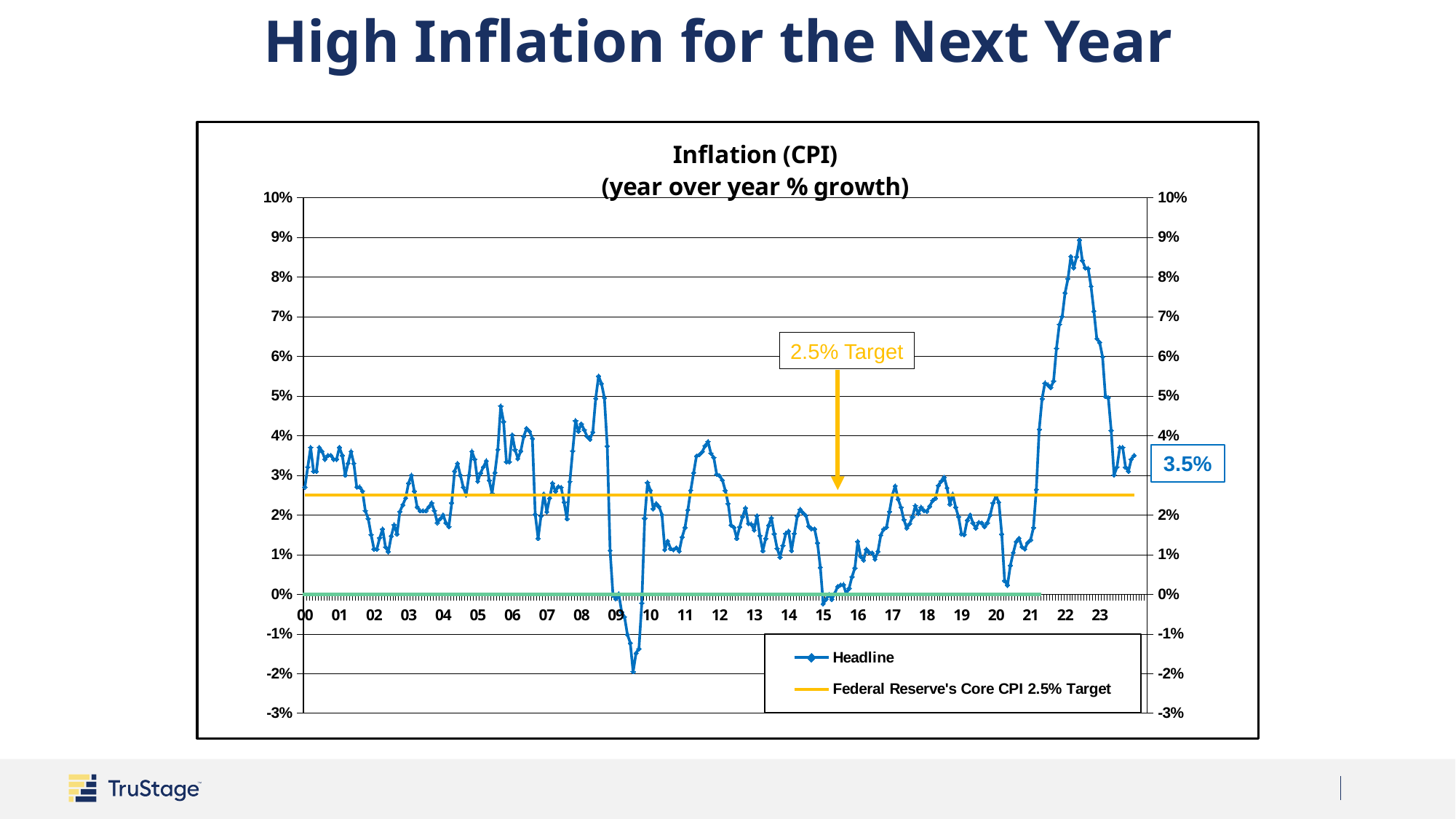
Which is larger, the latest labeled Headline value or the Federal Reserve's target? the latest Headline value (3.5%) What is the most recent Headline inflation value labeled on the chart? 3.5% What is the title of the chart? Inflation (CPI) (year over year % growth) What are the two legend entries on the chart? Headline; Federal Reserve's Core CPI 2.5% Target Is the peak Headline inflation value around 2022 greater or less than 8%? greater Is the lowest Headline inflation value around 2009 greater or less than -1%? less Is the Headline inflation value in 2015 greater or less than 1%? less How many series does the legend list? 2 By how much does the latest labeled Headline value (3.5%) exceed the 2.5% target? 1% What kind of chart is shown on the slide? line chart Do Headline inflation values rise or fall from the 2022 peak to the end of 2023? fall What value is the Federal Reserve's Core CPI target line set at? 2.5%